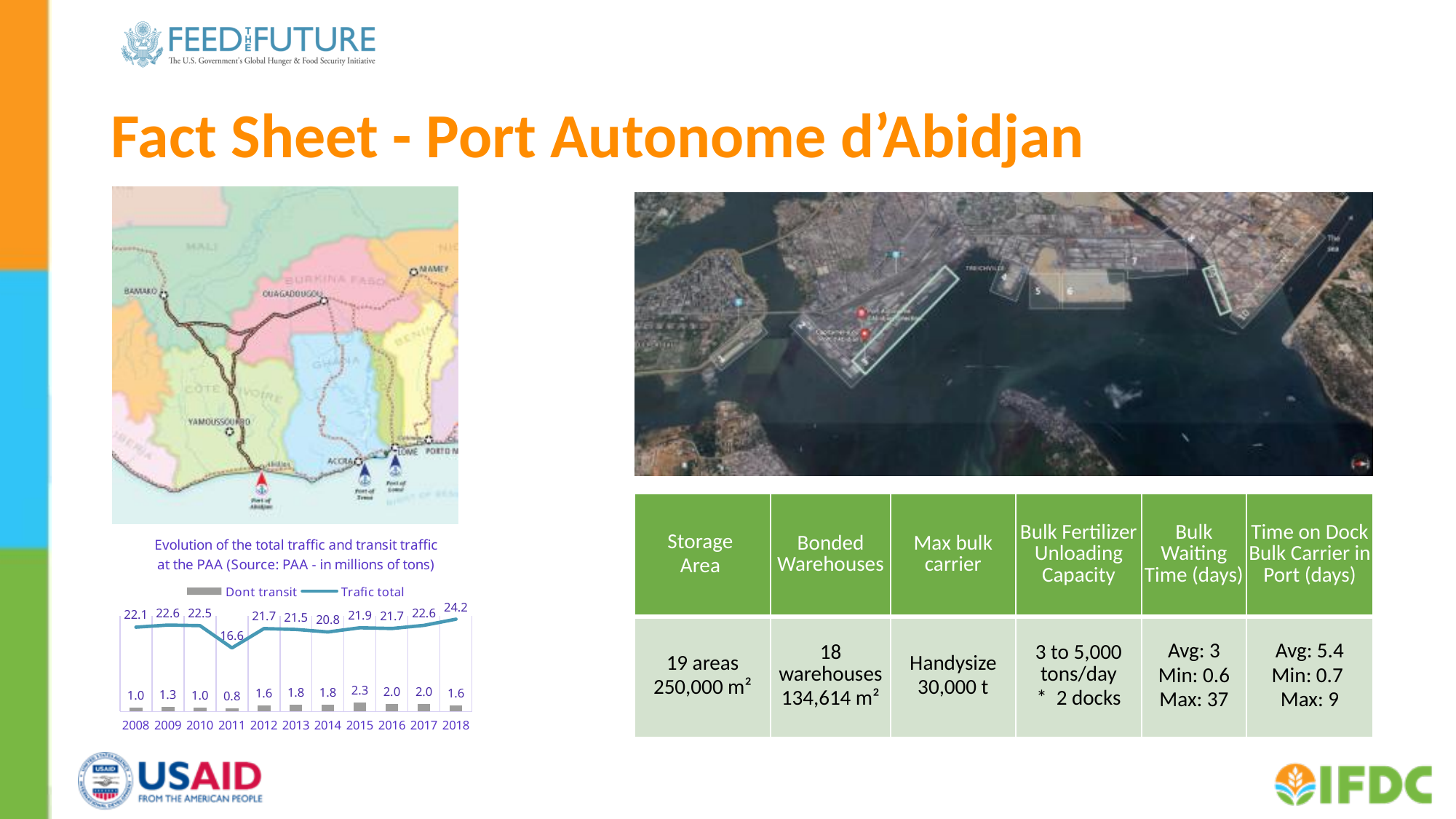
In which year is Trafic total the highest? 2018 What is the value of Trafic total for 2018? 24.2 What is the value of Dont transit for 2015? 2.3 How many years are shown on the x axis of the chart? 11 In which year is Dont transit the highest? 2015 What is the difference between Trafic total in 2018 and in 2017? 1.6 How many series does the chart legend list? 2 In which year is Dont transit the lowest? 2011 In which year is Trafic total the lowest? 2011 What is the value of Trafic total for 2011? 16.6 What is the title of the chart on the slide? Evolution of the total traffic and transit traffic at the PAA (Source: PAA - in millions of tons) Which is larger, Dont transit in 2012 or in 2013? 2013